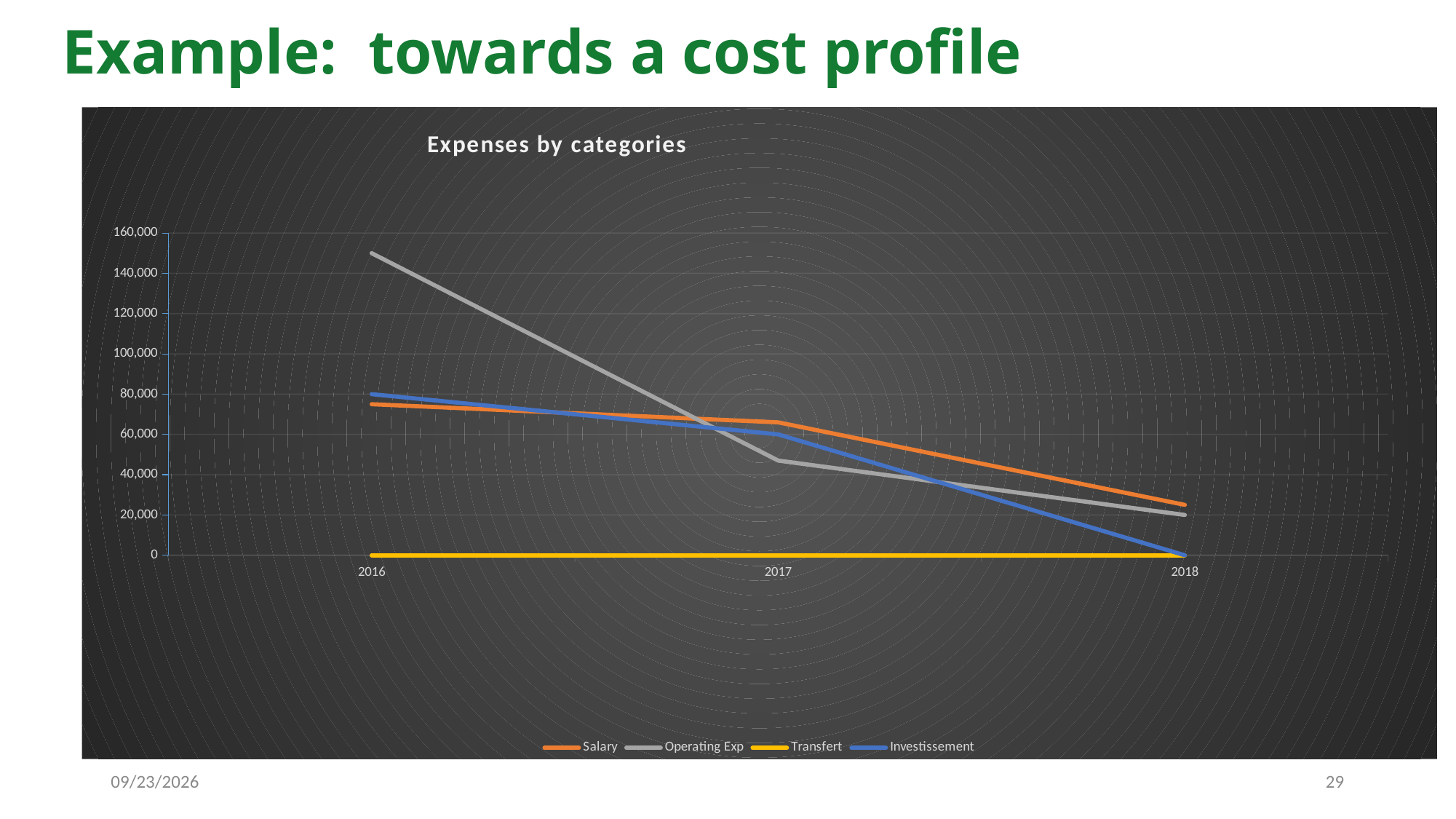
In 2018, which is larger, Salary or Operating Exp? Salary What kind of chart is shown on the slide? line chart What is the value for Investissement in 2018? 0 How many years are shown on the x axis? 3 Does the Operating Exp line rise or fall from 2016 to 2018? fall What is the title of the chart? Expenses by categories Is the value for Salary in 2017 greater or less than 60,000? greater What is the value for Transfert in 2018? 0 Which series has the lowest value in 2016? Transfert How many series does the legend list? 4 Which series has the highest value in 2016? Operating Exp Is the value for Operating Exp in 2016 greater or less than 140,000? greater